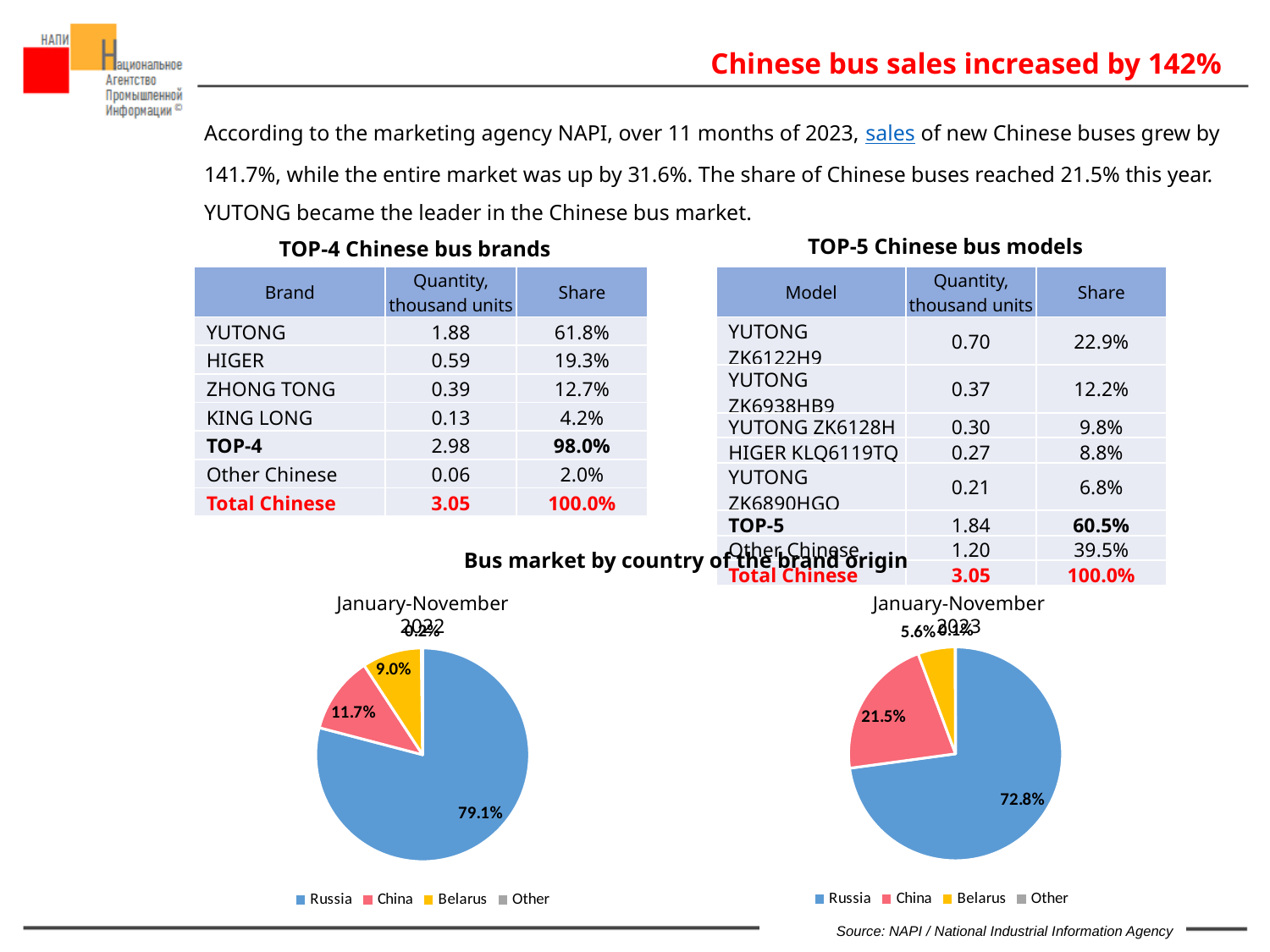
In the January-November 2023 pie chart, what share does China hold? 21.5% In the January-November 2022 pie chart, which country has the largest share? Russia What is the difference between China's share in the January-November 2023 pie chart and its share in the January-November 2022 pie chart? 9.8% In the January-November 2022 pie chart, what share does Belarus hold? 9.0% In the January-November 2023 pie chart, what share does Belarus hold? 5.6% In the January-November 2023 pie chart, which country has the largest share? Russia In the January-November 2022 pie chart, what share does Russia hold? 79.1% What is the difference between Russia's share in the January-November 2022 pie chart and its share in the January-November 2023 pie chart? 6.3% In the January-November 2023 pie chart, which is larger, the share of China or the share of Belarus? China How many entries does the legend of the January-November 2023 pie chart list? 4 In the January-November 2022 pie chart, what share does China hold? 11.7% What type of chart is used to show the bus market by country of the brand origin? Pie chart